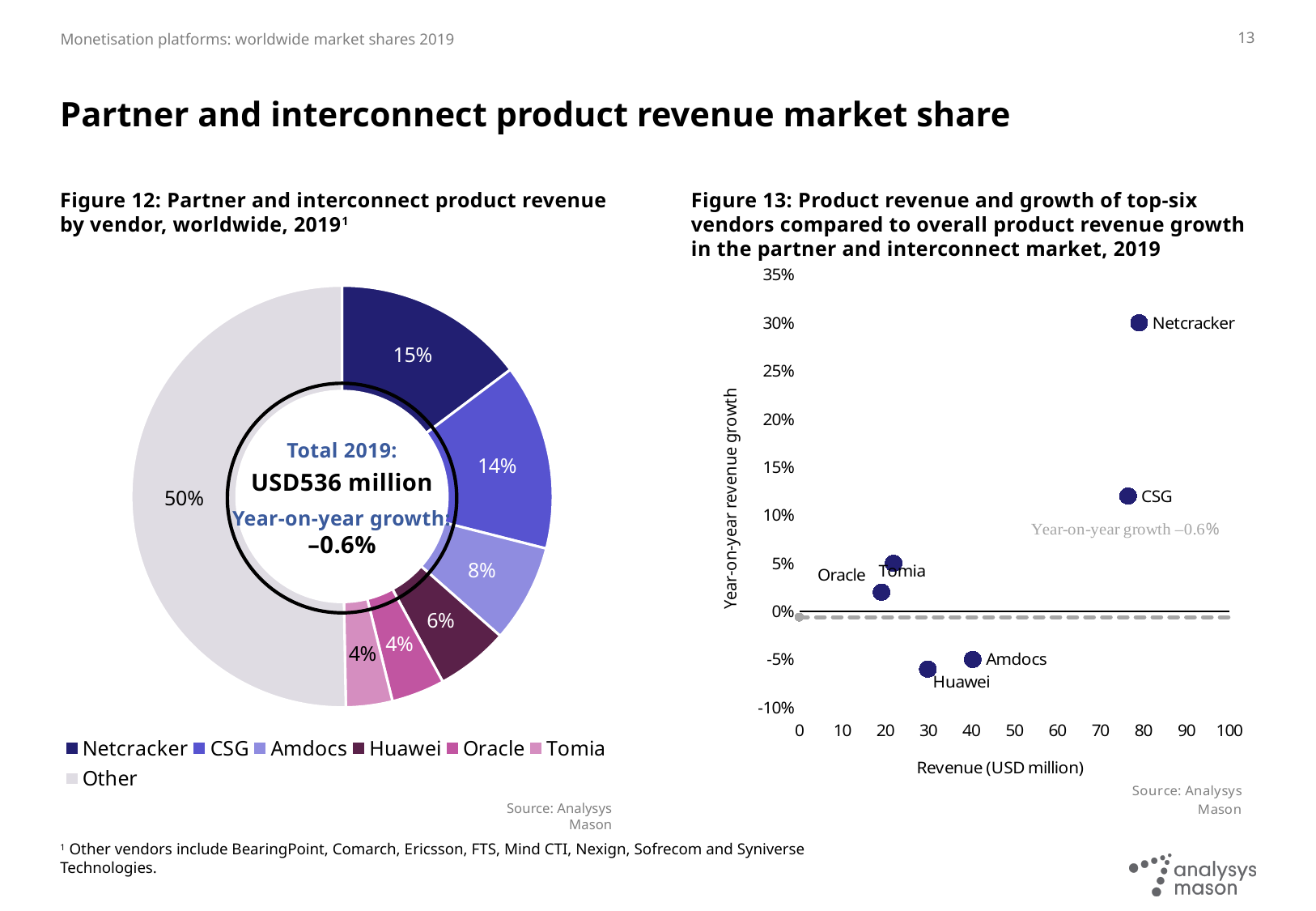
In Figure 13, which vendor has the highest year-on-year revenue growth? Netcracker In Figure 12, which named vendor has the largest share? Netcracker In Figure 12, how many entries does the legend list? 7 In Figure 12, what is the total 2019 partner and interconnect product revenue shown in the centre of the chart? USD536 million What kind of chart is Figure 12? Donut (pie) chart In Figure 13, is the year-on-year revenue growth for Netcracker greater or less than 25%? greater In Figure 12, what share is shown for Amdocs? 8% In Figure 12, what share is shown for CSG? 14% In Figure 12, which is larger, the share for CSG or the share for Amdocs? CSG In Figure 12, what is the difference in share between Netcracker and Huawei? 9 percentage points In Figure 13, is the revenue for Huawei greater or less than 40 USD million? less In Figure 12, what share of partner and interconnect product revenue does Netcracker hold? 15%